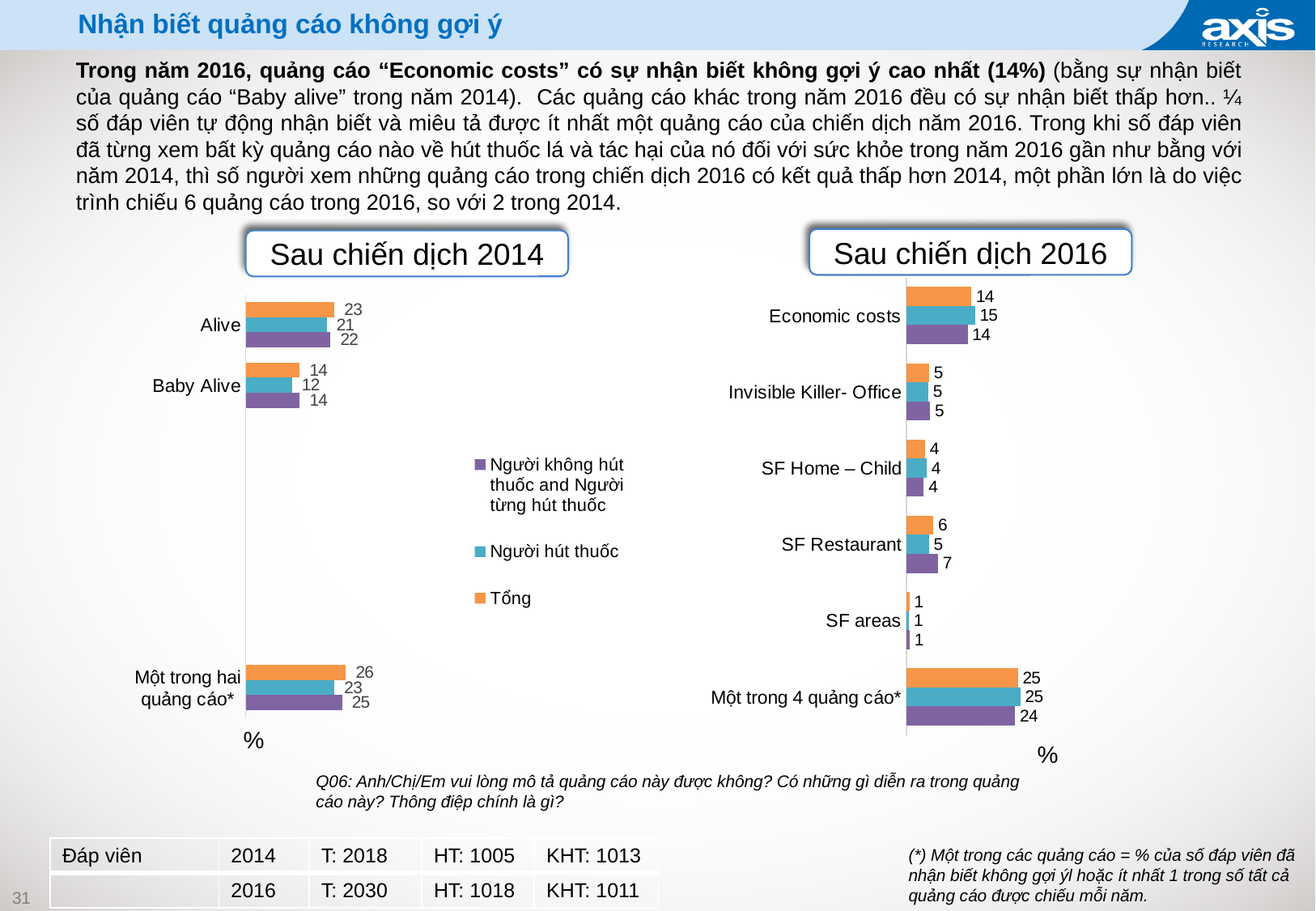
In the "Sau chiến dịch 2014" chart, what is the difference between the Tổng values for Alive and Baby Alive? 9 In the "Sau chiến dịch 2016" chart, what is the difference between the Tổng values for Economic costs and SF Restaurant? 8 In the "Sau chiến dịch 2014" chart, what is the Người hút thuốc value for Baby Alive? 12 How many series does the legend list? 3 What type of chart is the "Sau chiến dịch 2014" chart? Bar chart In the "Sau chiến dịch 2014" chart, is the Tổng value for Alive larger or smaller than the Tổng value for Baby Alive? larger In the "Sau chiến dịch 2014" chart, what is the Tổng value for Alive? 23 How many advertisement categories are shown in the "Sau chiến dịch 2016" chart? 6 In the "Sau chiến dịch 2016" chart, which individual advertisement (excluding "Một trong 4 quảng cáo*") has the highest Tổng value? Economic costs In the "Sau chiến dịch 2016" chart, what is the Người không hút thuốc and Người từng hút thuốc value for SF Restaurant? 7 In the "Sau chiến dịch 2016" chart, which advertisement has the lowest Tổng value? SF areas In the "Sau chiến dịch 2016" chart, what is the Người hút thuốc value for Economic costs? 15